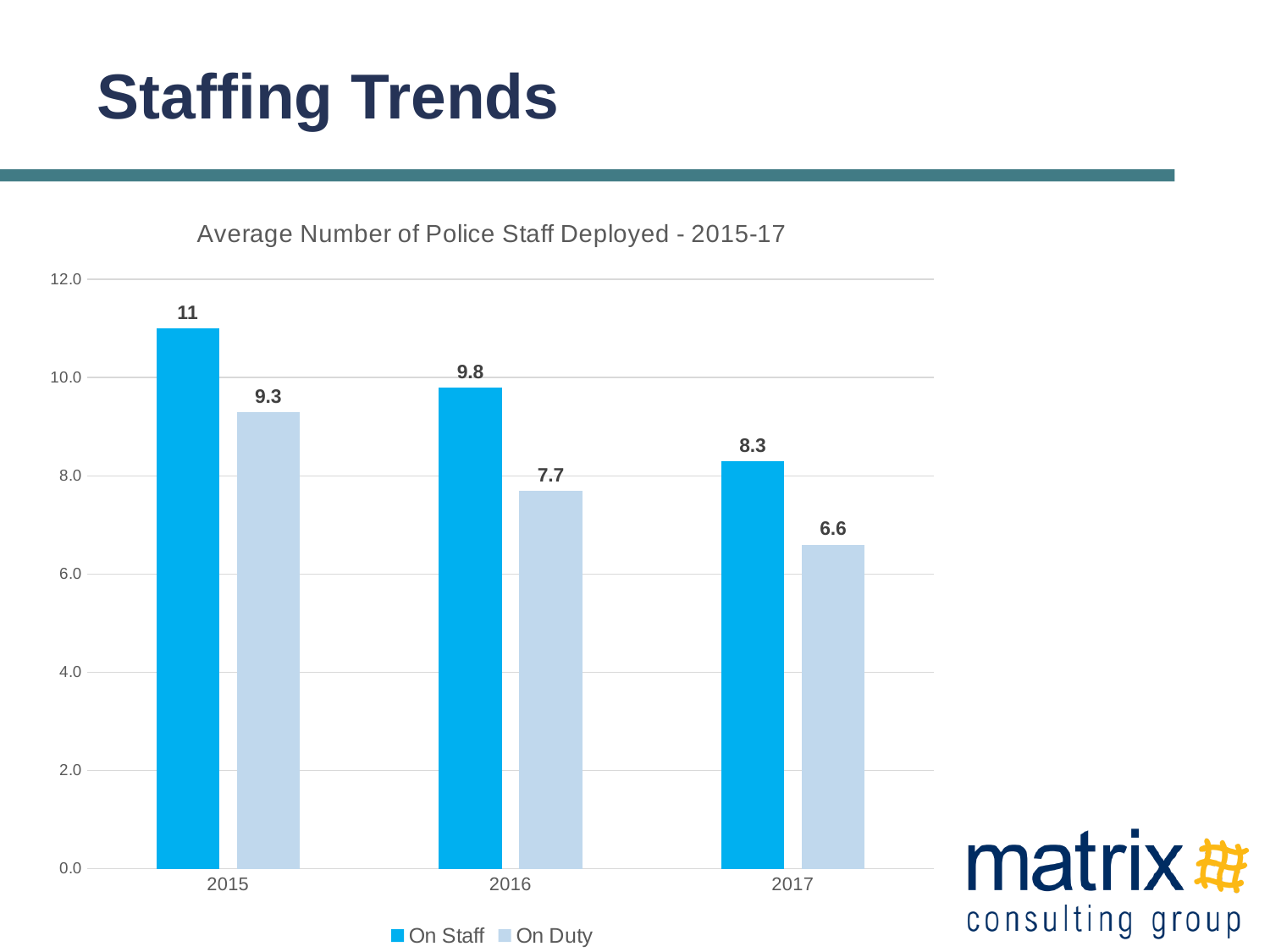
Which year has the lowest On Duty value? 2017 Which year has the highest On Staff value? 2015 What is the On Staff value for 2015? 11 What kind of chart is shown on the slide? Bar chart How many years are shown on the x axis? 3 What is the difference between the On Staff values for 2015 and 2017? 2.7 What is the On Duty value for 2017? 6.6 What is the difference between the On Staff and On Duty values in 2016? 2.1 Which is larger, the On Duty value for 2015 or the On Staff value for 2017? On Duty value for 2015 What is the On Duty value for 2016? 7.7 Do the On Staff values rise or fall from 2015 to 2017? Fall How many series does the legend list? 2